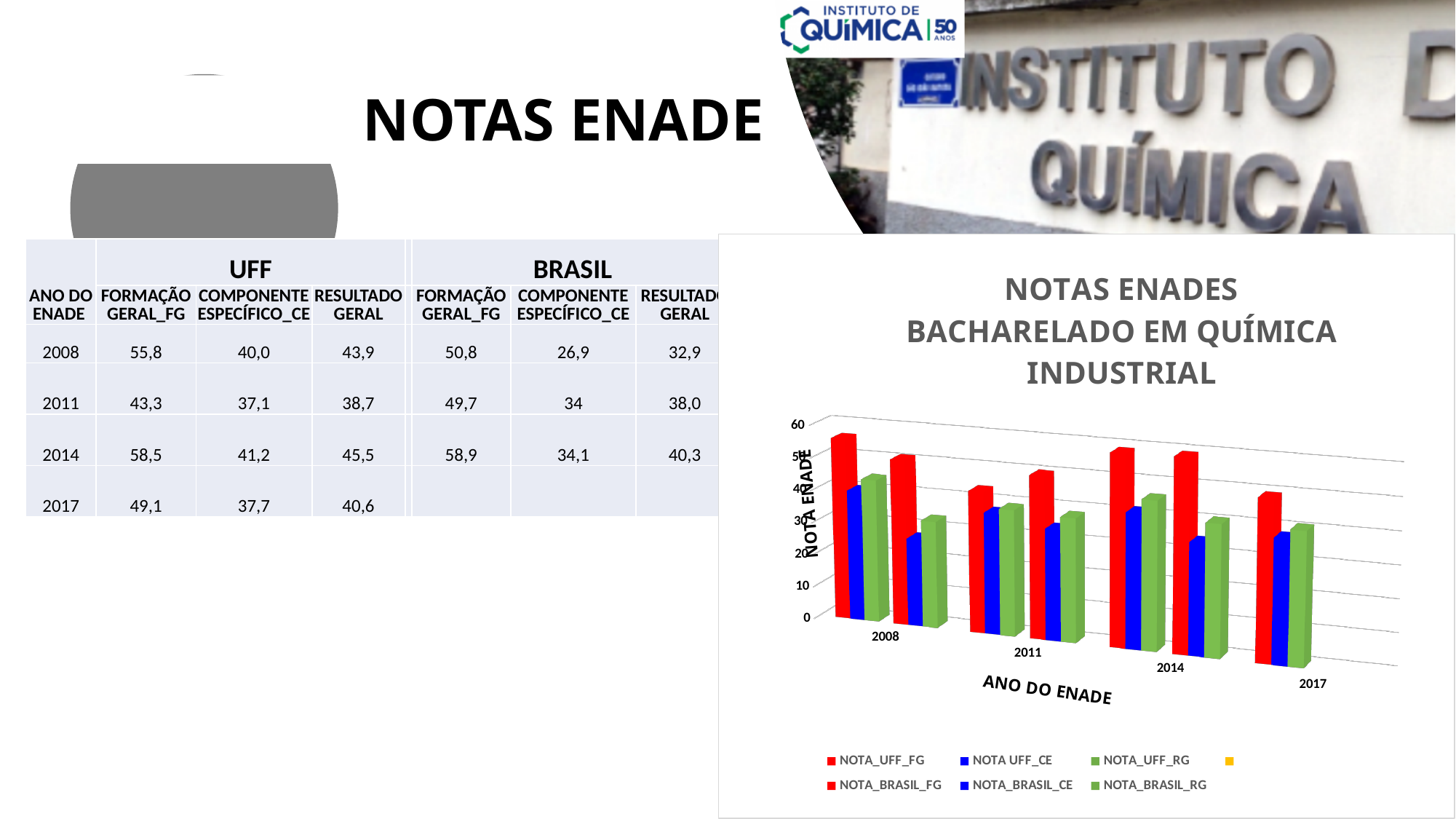
Is the value of NOTA_BRASIL_RG for 2008 greater or less than 40? less How many years are shown on the x axis of the chart? 4 For 2008, which is larger: NOTA_UFF_FG or NOTA_BRASIL_FG? NOTA_UFF_FG Is the value of NOTA_UFF_FG for 2014 greater or less than 50? greater What is the label of the x axis of the chart? ANO DO ENADE What kind of chart is shown on the slide? bar chart Which year on the chart has bars only for UFF and none for Brasil? 2017 Is the value of NOTA_BRASIL_CE for 2008 greater or less than 30? less What is the title of the chart? NOTAS ENADES BACHARELADO EM QUÍMICA INDUSTRIAL For 2008, which is larger: NOTA_UFF_CE or NOTA_BRASIL_CE? NOTA_UFF_CE